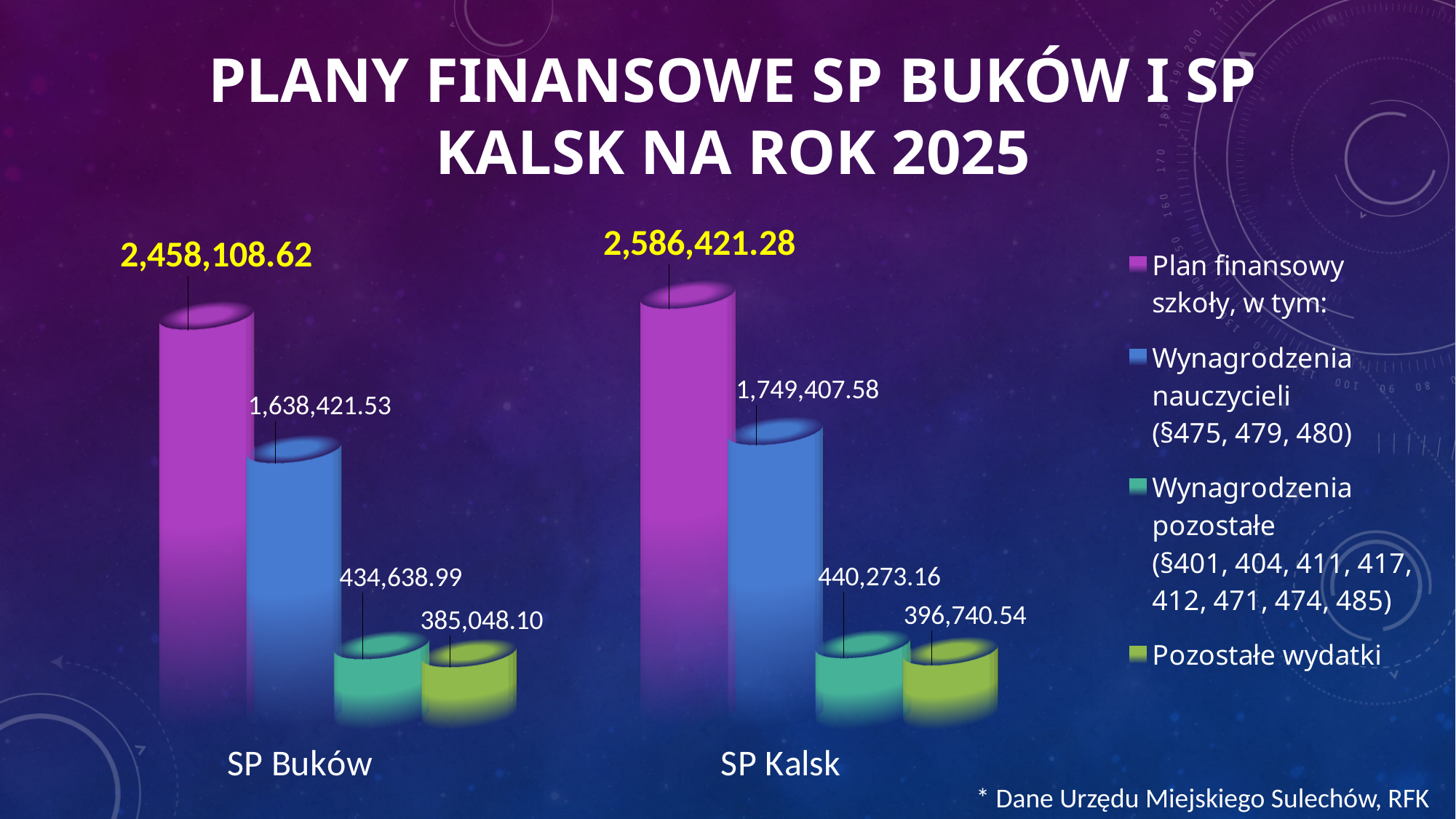
What kind of chart is shown on the slide? Bar chart What is the difference between the Plan finansowy szkoły values of SP Kalsk and SP Buków? 128,312.66 What is the difference between the Wynagrodzenia nauczycieli values of SP Kalsk and SP Buków? 110,986.05 What is the value of Wynagrodzenia pozostałe for SP Kalsk? 440,273.16 What is the value of Plan finansowy szkoły for SP Kalsk? 2,586,421.28 What is the value of Plan finansowy szkoły for SP Buków? 2,458,108.62 How many series does the legend list? 4 Which school has the higher Plan finansowy szkoły value? SP Kalsk What is the value of Pozostałe wydatki for SP Buków? 385,048.10 What is the value of Wynagrodzenia nauczycieli for SP Kalsk? 1,749,407.58 How many categories (schools) are shown on the x axis? 2 Which series has the lowest value for SP Buków? Pozostałe wydatki